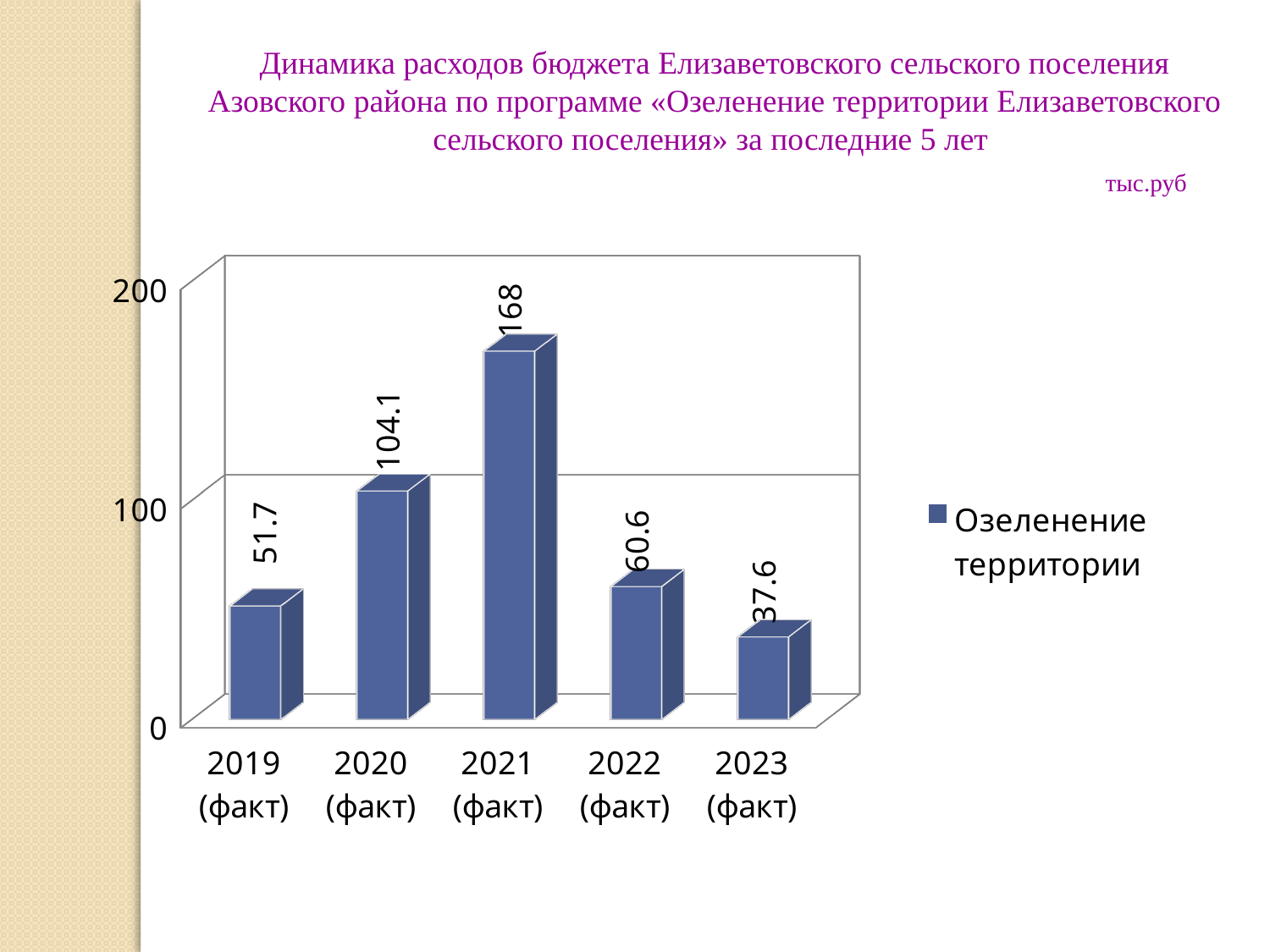
What is the value for 2021 (факт)? 168 Which year has the lowest value? 2023 (факт) What is the value for 2019 (факт)? 51.7 Which is larger, the value for 2020 (факт) or the value for 2022 (факт)? 2020 (факт) How many categories are shown on the x axis? 5 What is the value for 2023 (факт)? 37.6 What kind of chart is shown on the slide? bar chart What is the difference between the values for 2022 (факт) and 2023 (факт)? 23 What is the difference between the values for 2021 (факт) and 2020 (факт)? 63.9 Which year has the highest value? 2021 (факт) Is the value for 2020 (факт) greater or less than 100? greater What series name does the legend list? Озеленение территории